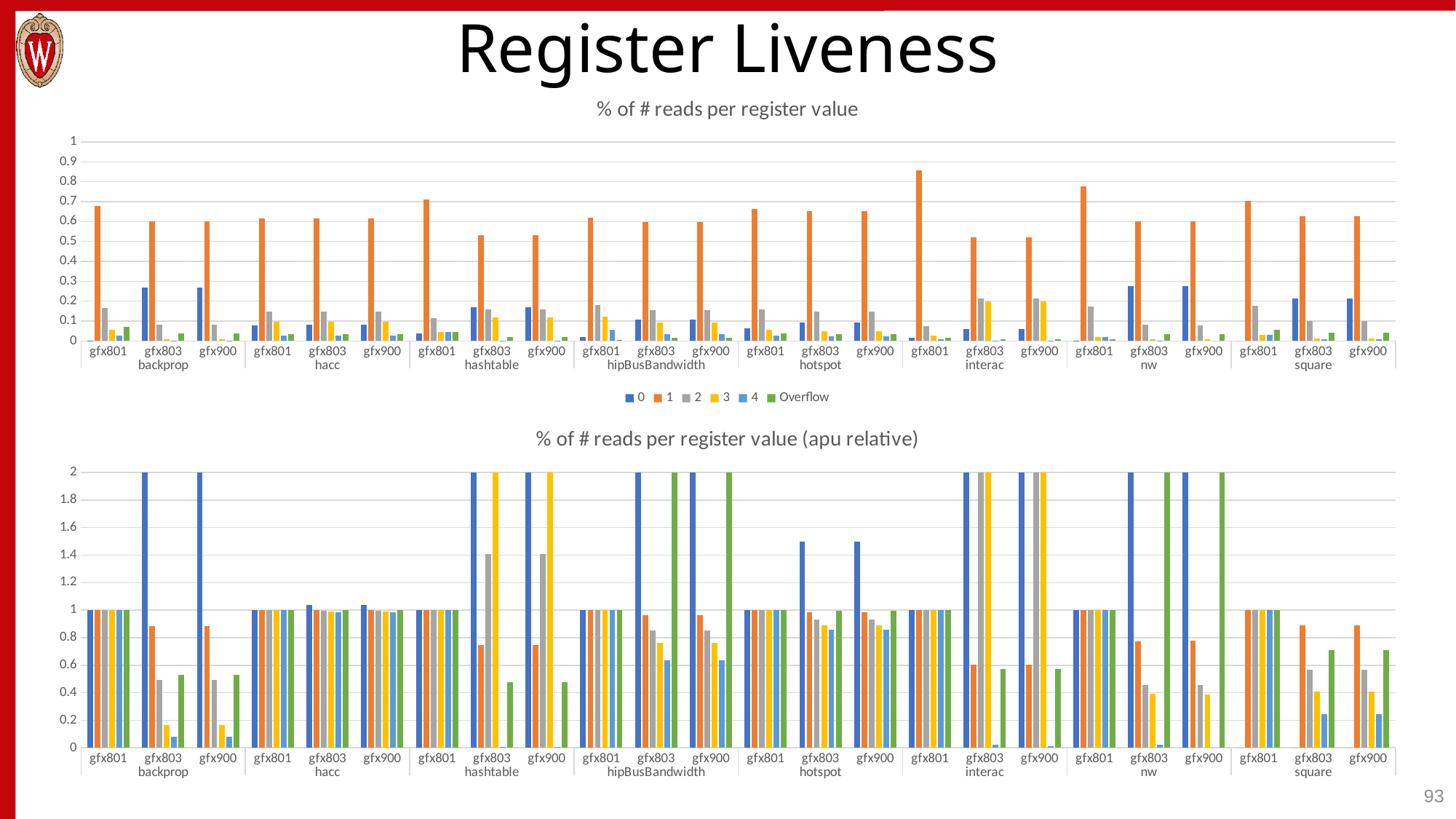
In the top chart, is the value of series "1" for gfx803 hashtable greater or less than 0.6? less In the top chart, which is larger for series "0": gfx801 backprop or gfx803 backprop? gfx803 backprop In the bottom chart, is the value of series "1" for gfx803 backprop greater or less than 1? less How many series does the legend of the top chart list? 6 In the bottom chart, is the value of series "0" for gfx803 hotspot greater or less than 1.2? greater What kind of chart is the top chart titled "% of # reads per register value"? bar chart In the top chart, which GPU/benchmark group has the highest bar for series "1"? gfx801 interac What are the legend entries of the top chart? 0, 1, 2, 3, 4, Overflow What is the title of the bottom chart? % of # reads per register value (apu relative) In the bottom chart, for gfx803 hashtable, which is larger: series "2" or series "3"? 3 How many benchmark groups (backprop, hacc, etc.) are shown along the x axis of the top chart? 8